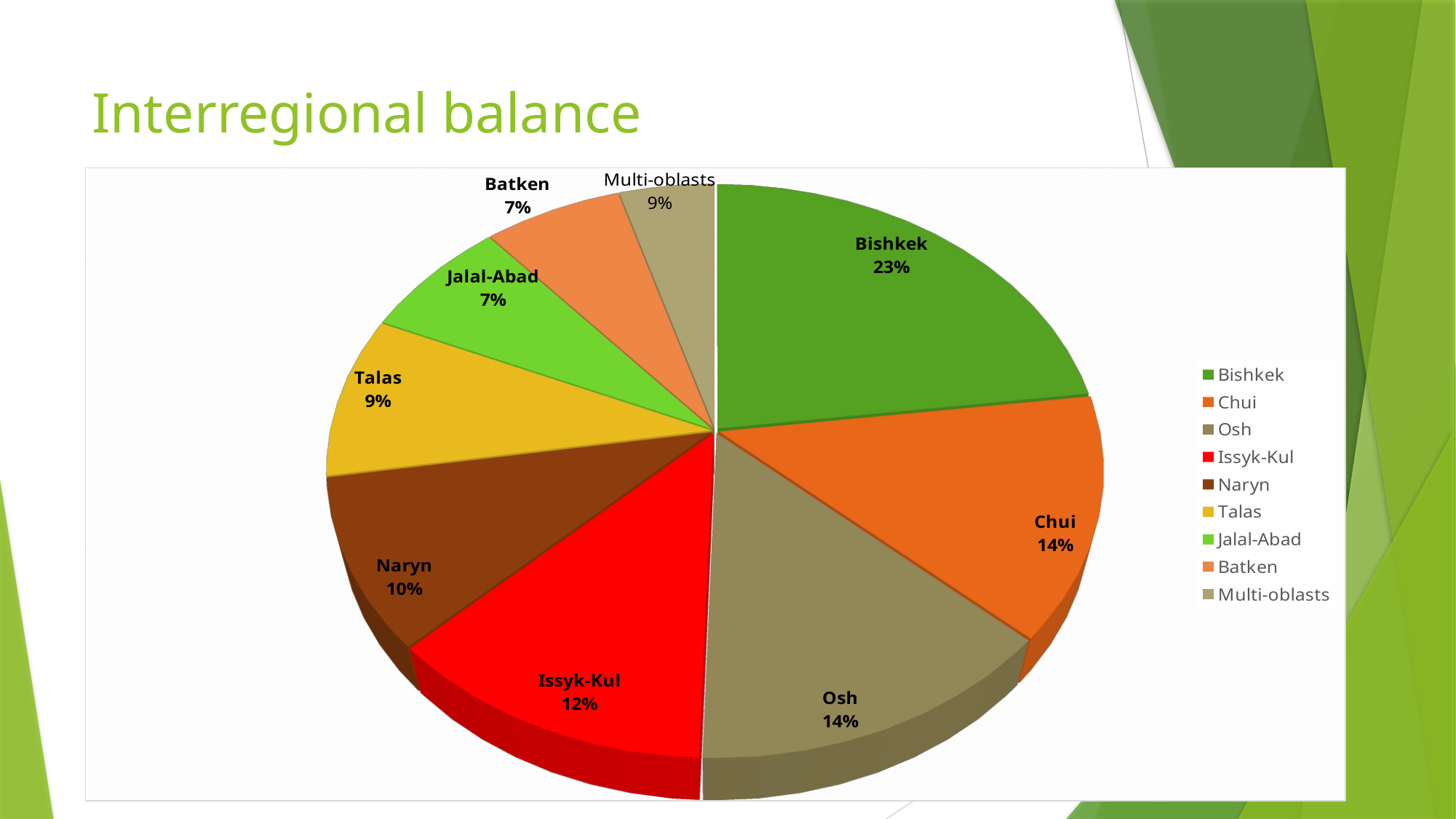
What is the difference between the shares of Issyk-Kul and Jalal-Abad? 5% Which region has the largest slice of the pie? Bishkek What is the value shown for Naryn? 10% What is the value shown for Issyk-Kul? 12% What share of the pie does Bishkek have? 23% Which is larger, the share for Naryn or the share for Talas? Naryn What kind of chart is shown on the slide? Pie chart How many slices does the pie chart have? 9 What is the title of the slide containing the chart? Interregional balance What is the value shown for Multi-oblasts? 9% How many entries does the legend list? 9 What is the difference between the shares of Bishkek and Chui? 9%